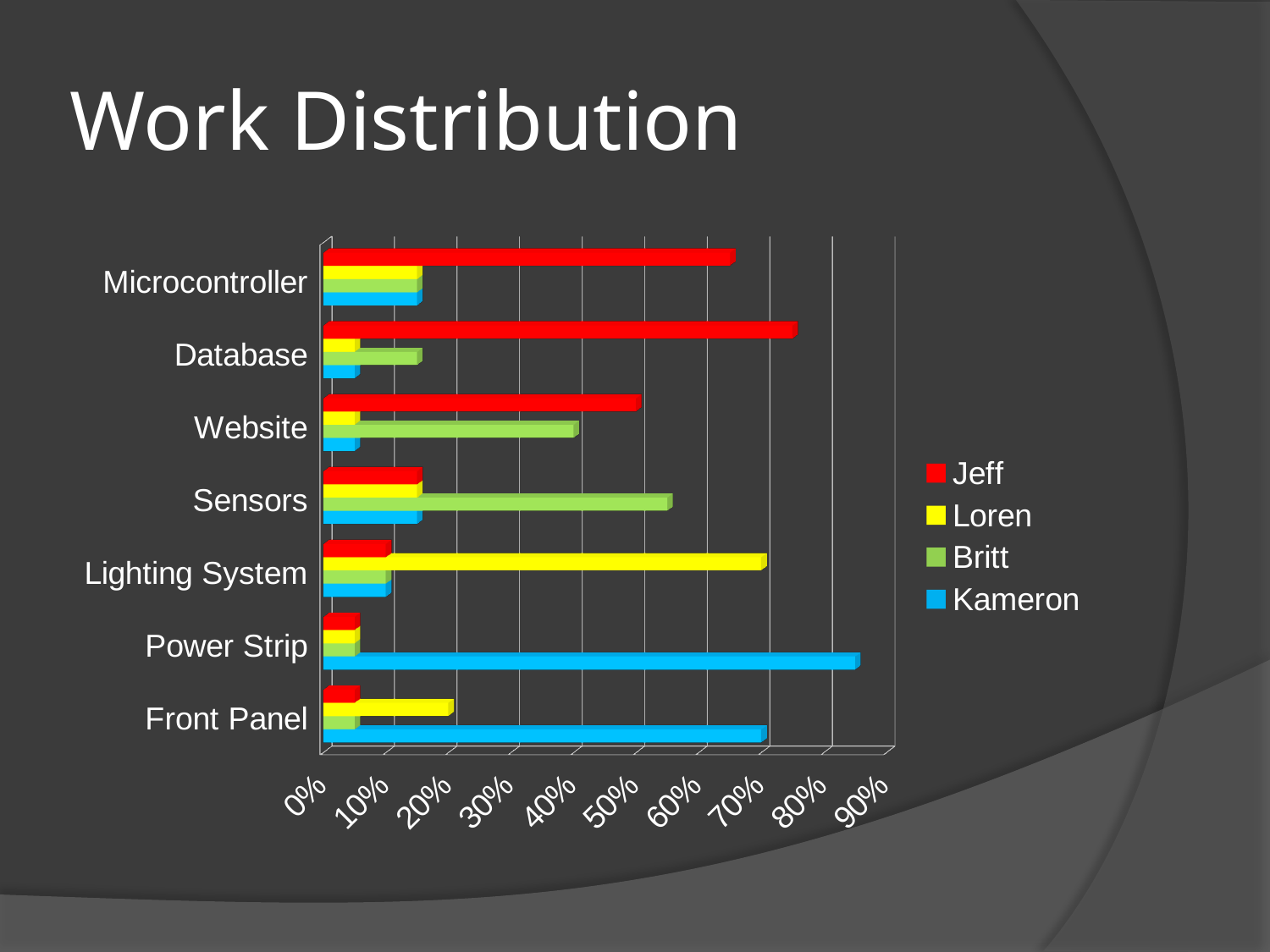
What is the title of the slide containing the chart? Work Distribution How many series does the chart's legend list? 4 How many categories are shown on the vertical axis of the chart? 7 Which series has the highest value for Lighting System? Loren Is the value for Jeff on Microcontroller greater or less than 60%? greater Is the value for Britt on Website greater or less than 30%? greater Which series has the highest value for Power Strip? Kameron For Sensors, which is larger: the value for Britt or the value for Jeff? Britt For which category is Jeff's bar the longest? Database What kind of chart is shown on the slide? bar chart Is the value for Kameron on Power Strip greater or less than 80%? greater Which series is shown in blue in the chart's legend? Kameron